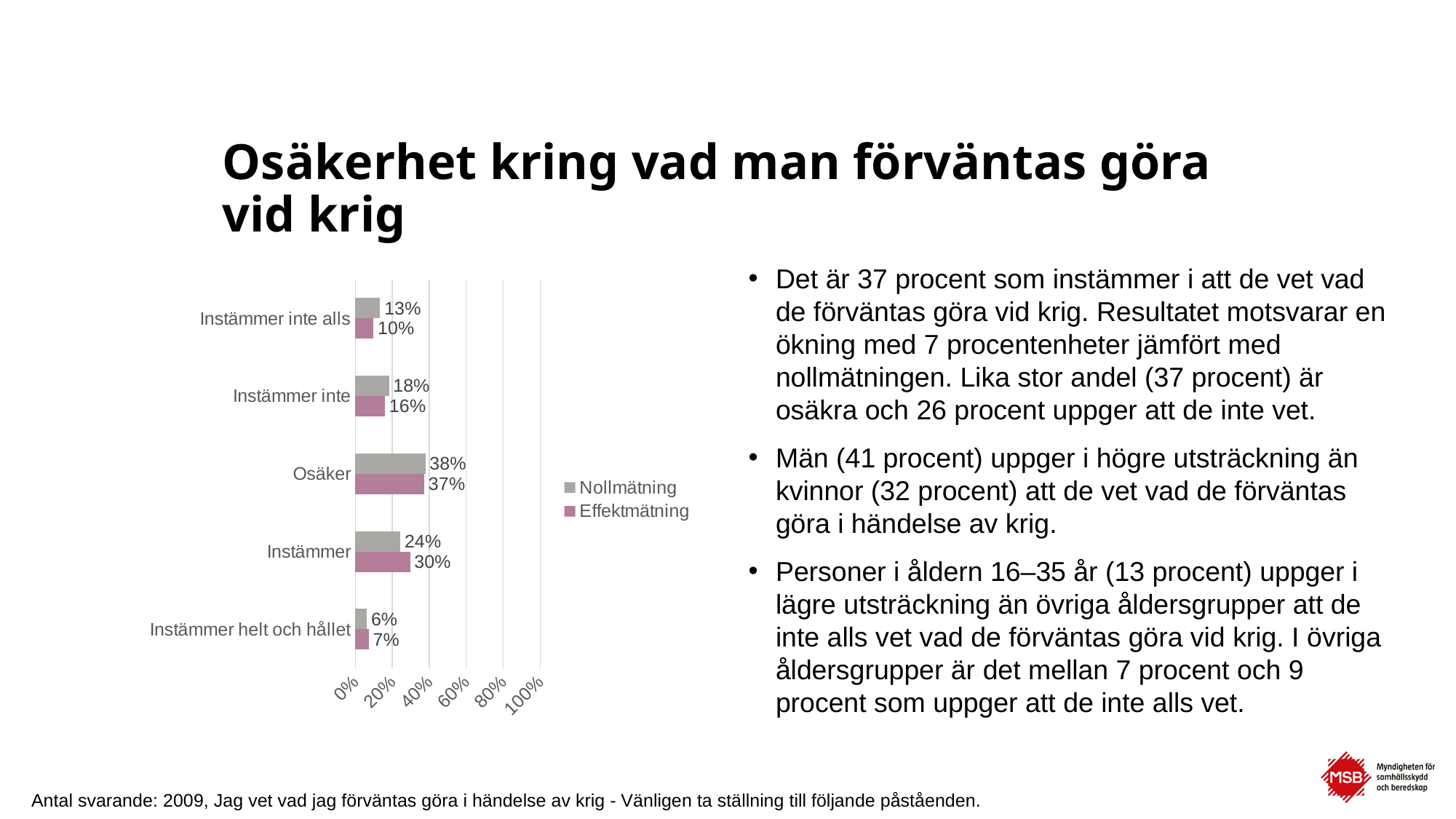
What is the Effektmätning value for Instämmer inte alls? 10% How many categories are shown on the chart? 5 Which series is shown in pink/purple in the legend? Effektmätning What is the Nollmätning value for Instämmer helt och hållet? 6% Which category has the highest Effektmätning value? Osäker Which category has the lowest Nollmätning value? Instämmer helt och hållet For Instämmer inte, which is larger: the Nollmätning value or the Effektmätning value? Nollmätning What is the difference between the Effektmätning and Nollmätning values for Instämmer? 6 percentage points What kind of chart is shown on the slide? Bar chart How many series does the legend list? 2 What is the Nollmätning value for Osäker? 38% What is the Effektmätning value for Instämmer? 30%